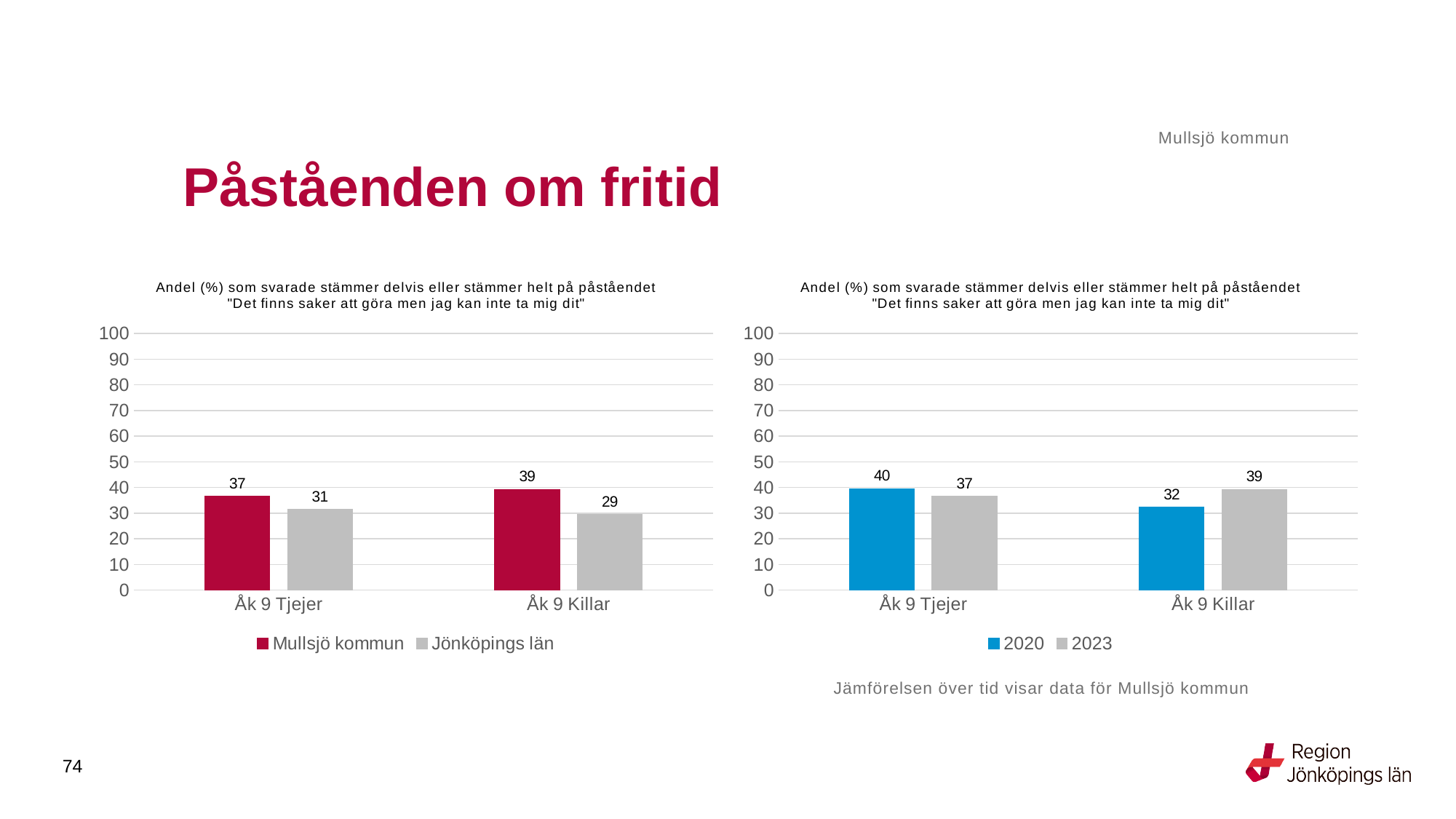
In the right chart, what is the value for 2020 for Åk 9 Killar? 32 In the left chart, what is the difference between Mullsjö kommun and Jönköpings län for Åk 9 Killar? 10 What type of chart is the left chart? Bar chart In the left chart, which bar has the lowest value? Jönköpings län, Åk 9 Killar In the left chart, what is the value for Jönköpings län for Åk 9 Killar? 29 In the left chart, which series has the higher value for Åk 9 Tjejer? Mullsjö kommun In the right chart, what is the difference between 2020 and 2023 for Åk 9 Tjejer? 3 In the right chart, what is the value for 2023 for Åk 9 Tjejer? 37 In the left chart, what is the value for Mullsjö kommun for Åk 9 Tjejer? 37 In the right chart, which is larger for Åk 9 Killar, 2020 or 2023? 2023 In the right chart, which bar has the highest value? 2020, Åk 9 Tjejer How many series does the legend of the right chart list? 2